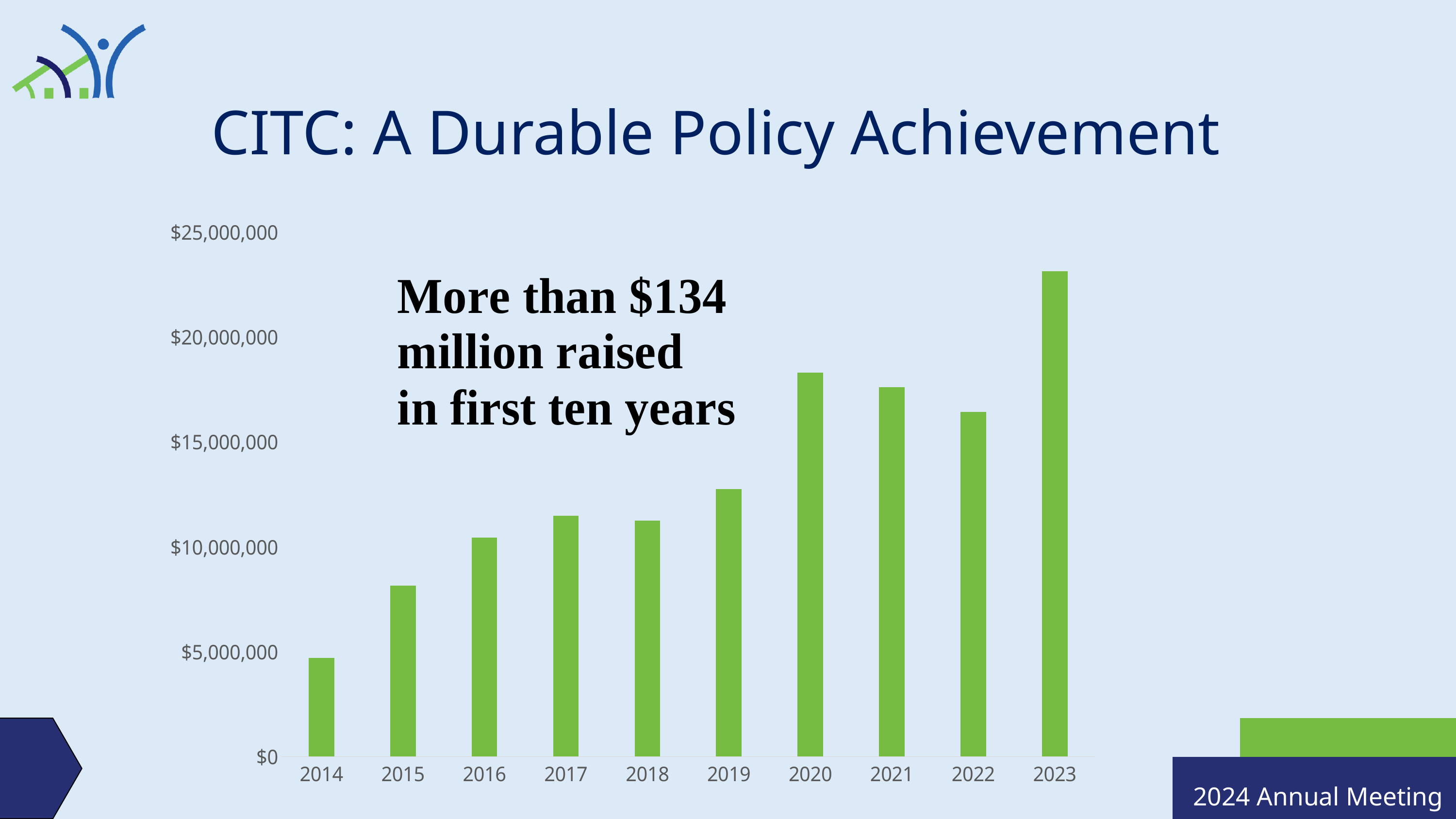
What kind of chart is shown on the slide? bar chart What is the title of the slide containing the chart? CITC: A Durable Policy Achievement Which year has the larger value, 2020 or 2019? 2020 Is the value for 2019 greater or less than $15,000,000? less Do the values generally rise or fall from 2014 to 2023? rise Which year has the lowest bar in the chart? 2014 Is the value for 2023 greater or less than $20,000,000? greater Is the value for 2016 greater or less than $10,000,000? greater Which year has the highest bar in the chart? 2023 How many years are shown on the x axis of the chart? 10